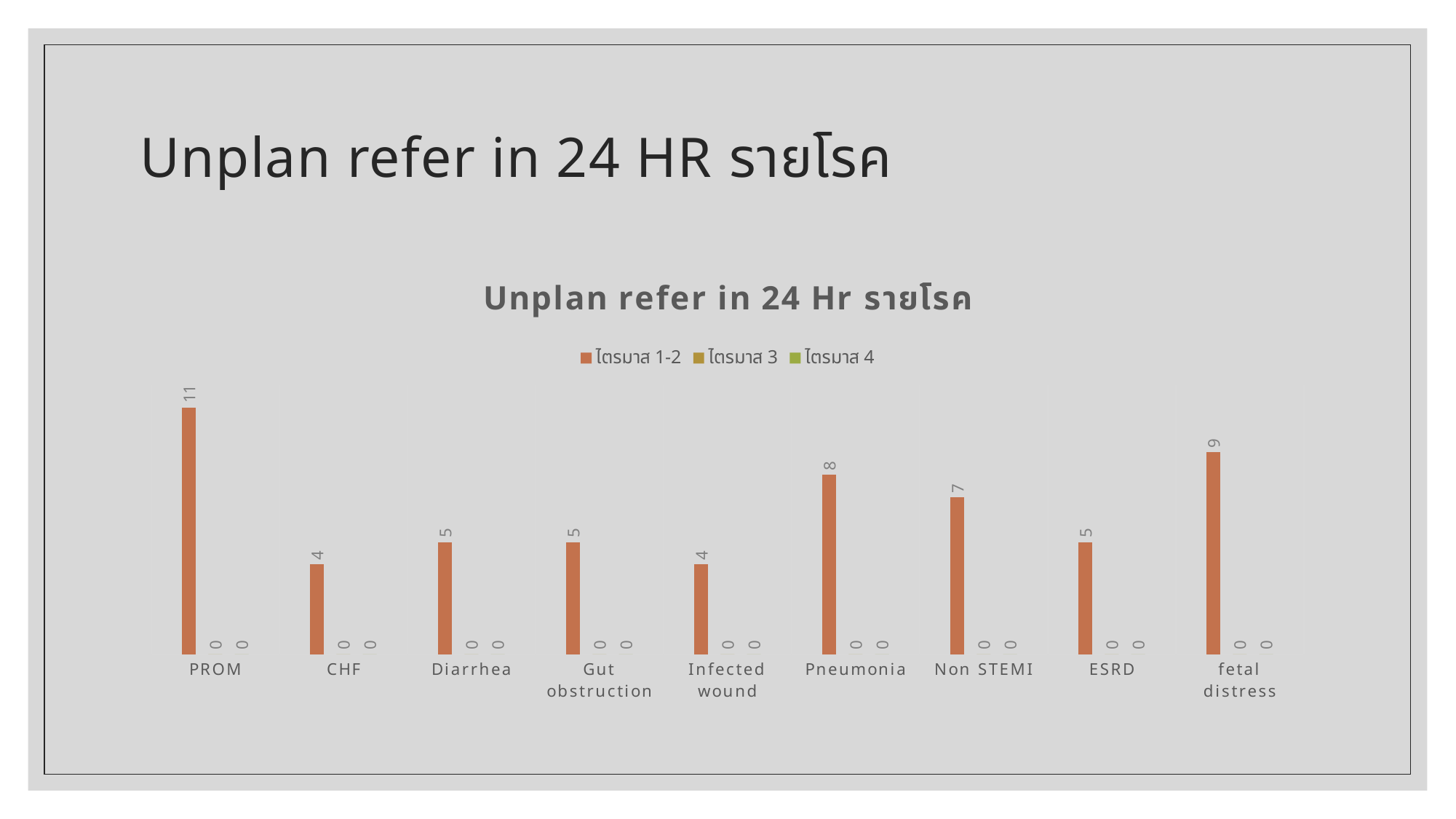
How many series does the legend list? 3 What is the difference between the ไตรมาส 1-2 values for PROM and CHF? 7 What is the value for ESRD in the ไตรมาส 3 series? 0 What is the value for PROM in the ไตรมาส 1-2 series? 11 What is the value for Pneumonia in the ไตรมาส 1-2 series? 8 What is the value for Non STEMI in the ไตรมาส 1-2 series? 7 What is the value for fetal distress in the ไตรมาส 1-2 series? 9 How many categories are shown on the x axis? 9 What is the title of the chart? Unplan refer in 24 Hr รายโรค Which category has the highest value in the ไตรมาส 1-2 series? PROM What kind of chart is shown? bar chart Which is larger in the ไตรมาส 1-2 series, Pneumonia or Non STEMI? Pneumonia